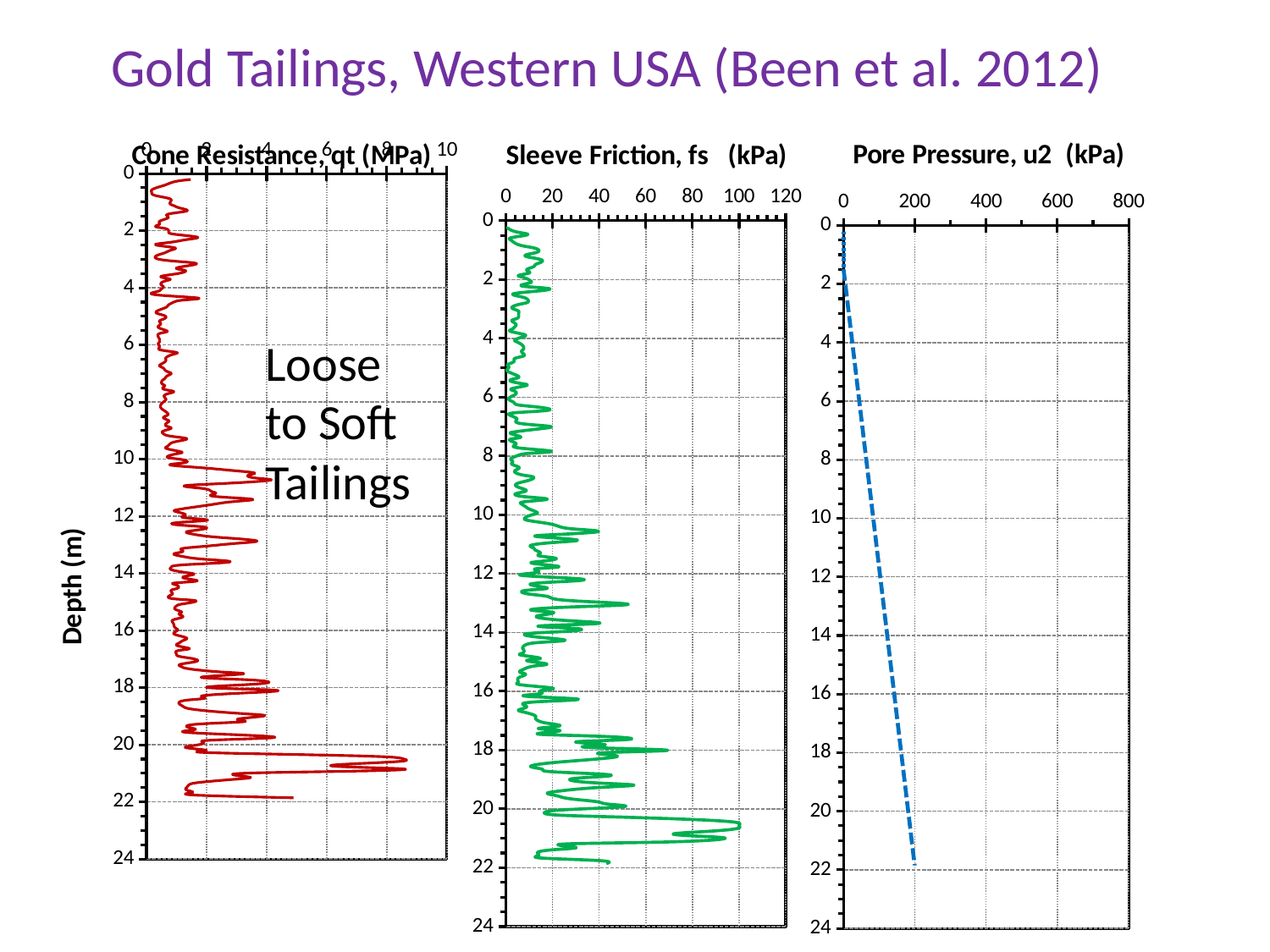
In the Pore Pressure, u2 (kPa) chart, is the pore pressure at 20 m depth greater or less than 400 kPa? less What text annotation is written inside the Cone Resistance, qt (MPa) chart? Loose to Soft Tailings How many charts are shown on the slide? 3 In the Pore Pressure, u2 (kPa) chart, what is the largest value shown on the horizontal axis? 800 What kind of chart is the Cone Resistance, qt (MPa) chart? line chart In the Sleeve Friction, fs (kPa) chart, is the peak sleeve friction near 20.5 m depth greater or less than 80 kPa? greater In the Pore Pressure, u2 (kPa) chart, does the pore pressure rise or fall as depth increases? rise In the Sleeve Friction, fs (kPa) chart, what is the deepest depth value labelled on the vertical axis? 24 In the Cone Resistance, qt (MPa) chart, is the cone resistance at 6 m depth greater or less than 2 MPa? less